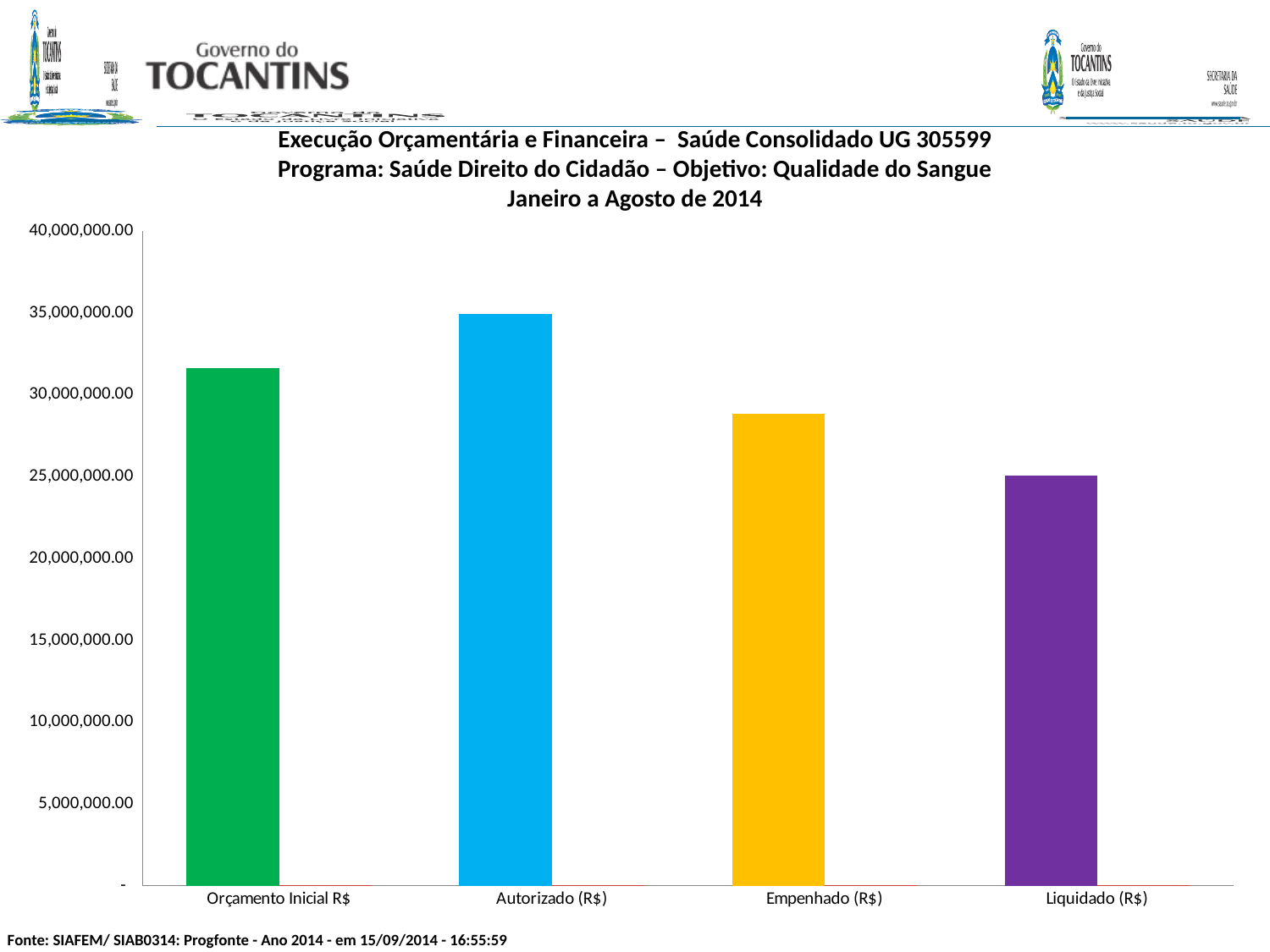
Is the value for Orçamento Inicial R$ greater or less than 35,000,000.00? less Is the value for Liquidado (R$) greater or less than 20,000,000.00? greater What kind of chart is shown on the slide? bar chart Is the value for Empenhado (R$) greater or less than 30,000,000.00? less Which is larger, Autorizado (R$) or Orçamento Inicial R$? Autorizado (R$) Which category has the lowest value? Liquidado (R$) How many categories are plotted on the chart? 4 Which is larger, Orçamento Inicial R$ or Empenhado (R$)? Orçamento Inicial R$ Do the values rise or fall from Autorizado (R$) to Liquidado (R$) along the x axis? fall Which category has the highest value? Autorizado (R$) What period does the chart title say the data covers? Janeiro a Agosto de 2014